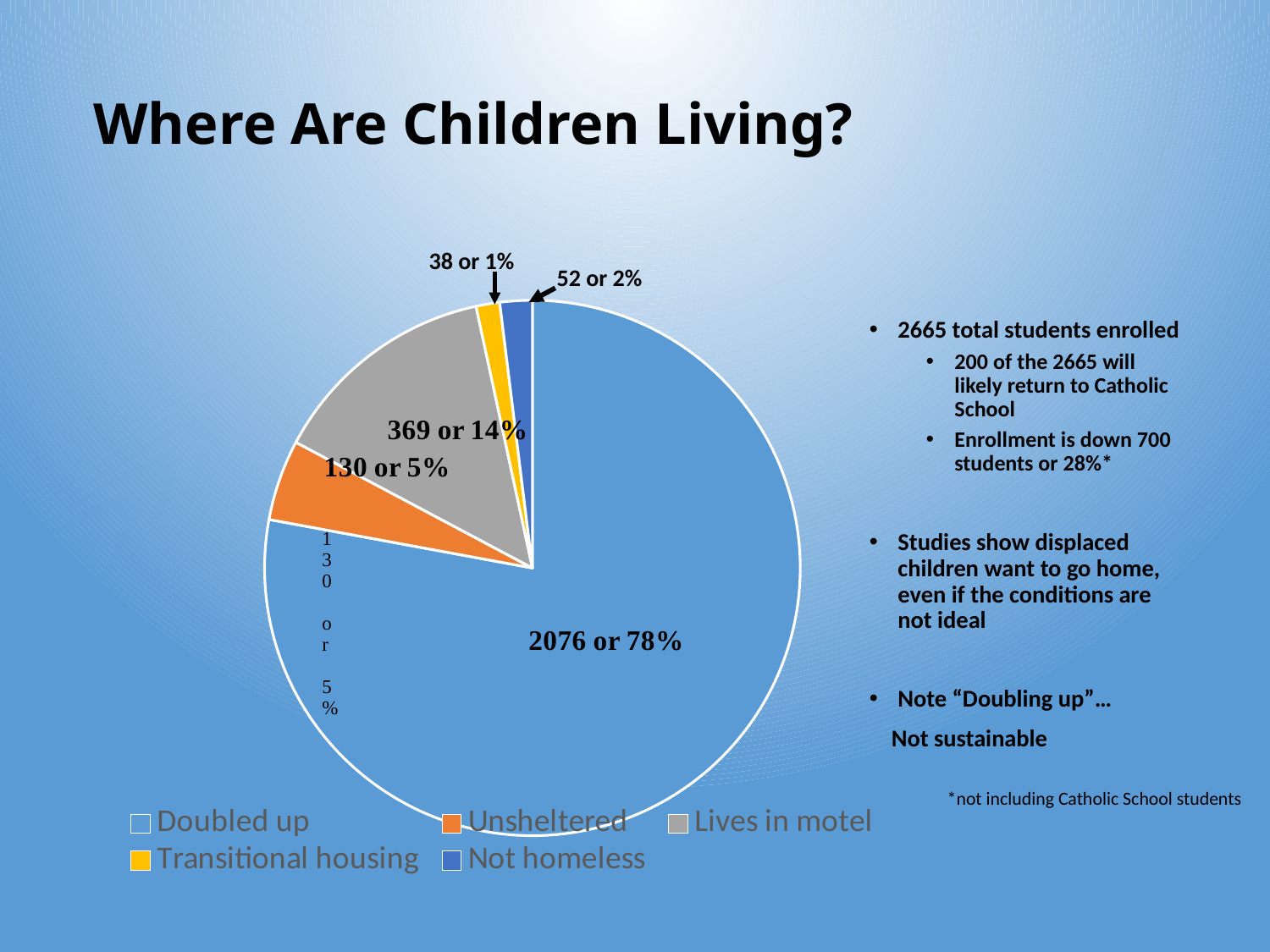
What is the value shown for the Doubled up slice? 2076 or 78% How many categories does the pie chart's legend list? 5 Which is larger, the Not homeless slice or the Transitional housing slice? Not homeless What share of the pie does the Lives in motel slice represent? 14% Which category has the smallest slice of the pie? Transitional housing Which category has the largest slice of the pie? Doubled up What is the value shown for the Unsheltered slice? 130 or 5% What is the value shown for the Not homeless slice? 52 or 2% What kind of chart is shown on the slide? Pie chart What is the value shown for the Lives in motel slice? 369 or 14% What is the value shown for the Transitional housing slice? 38 or 1% What is the difference in number of children between Lives in motel and Unsheltered? 239